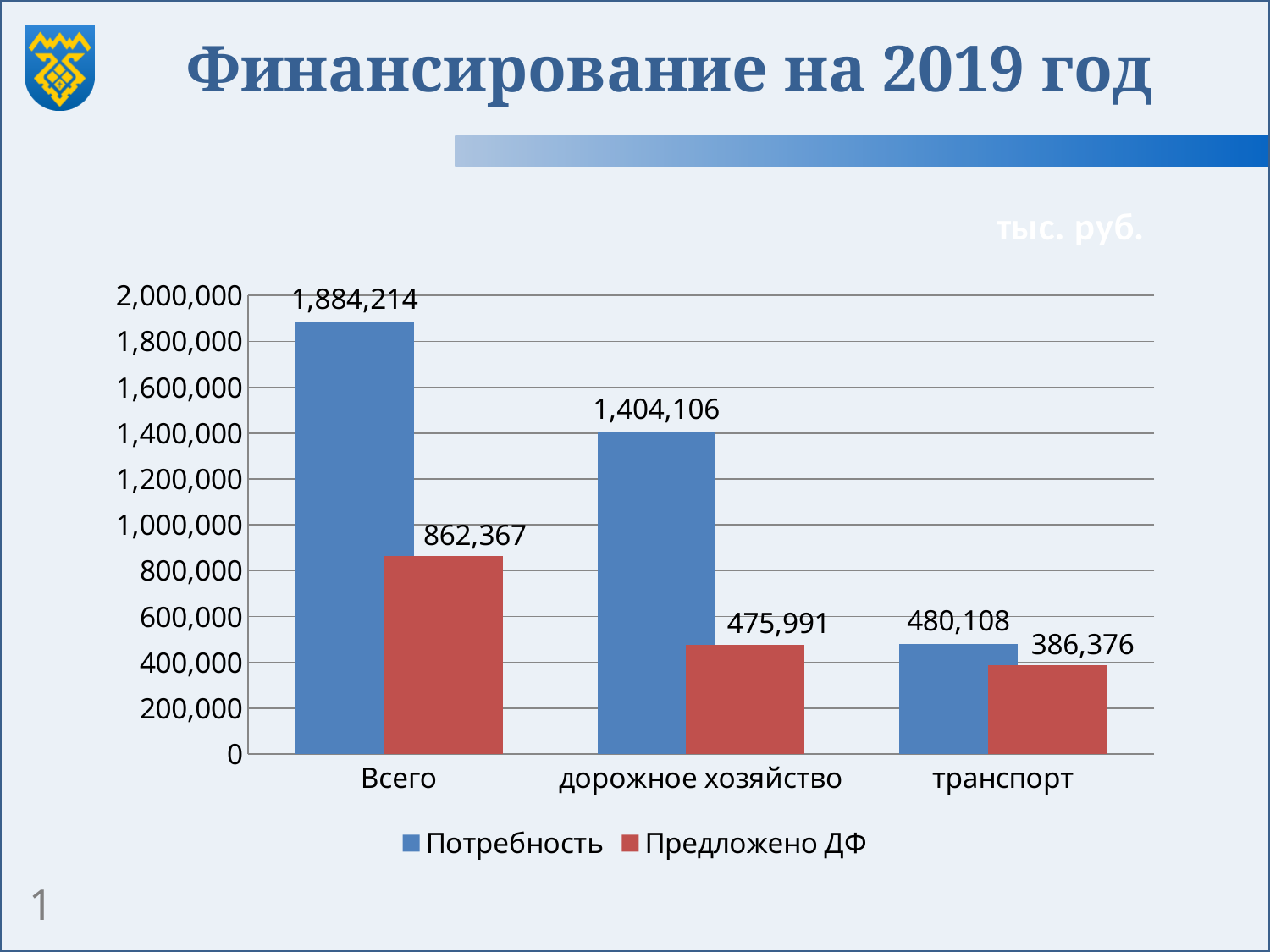
Which category has the highest Предложено ДФ value? Всего What kind of chart is shown on the slide? bar chart What is the Предложено ДФ value for дорожное хозяйство? 475,991 Which category has the lowest Потребность value? транспорт How many series does the legend list? 2 How many categories are shown on the x axis? 3 What is the difference between Потребность and Предложено ДФ for транспорт? 93,732 Which is larger for дорожное хозяйство: Потребность or Предложено ДФ? Потребность What is the Потребность value for дорожное хозяйство? 1,404,106 What is the Потребность value for Всего? 1,884,214 What is the Предложено ДФ value for транспорт? 386,376 What is the difference between Потребность and Предложено ДФ for Всего? 1,021,847